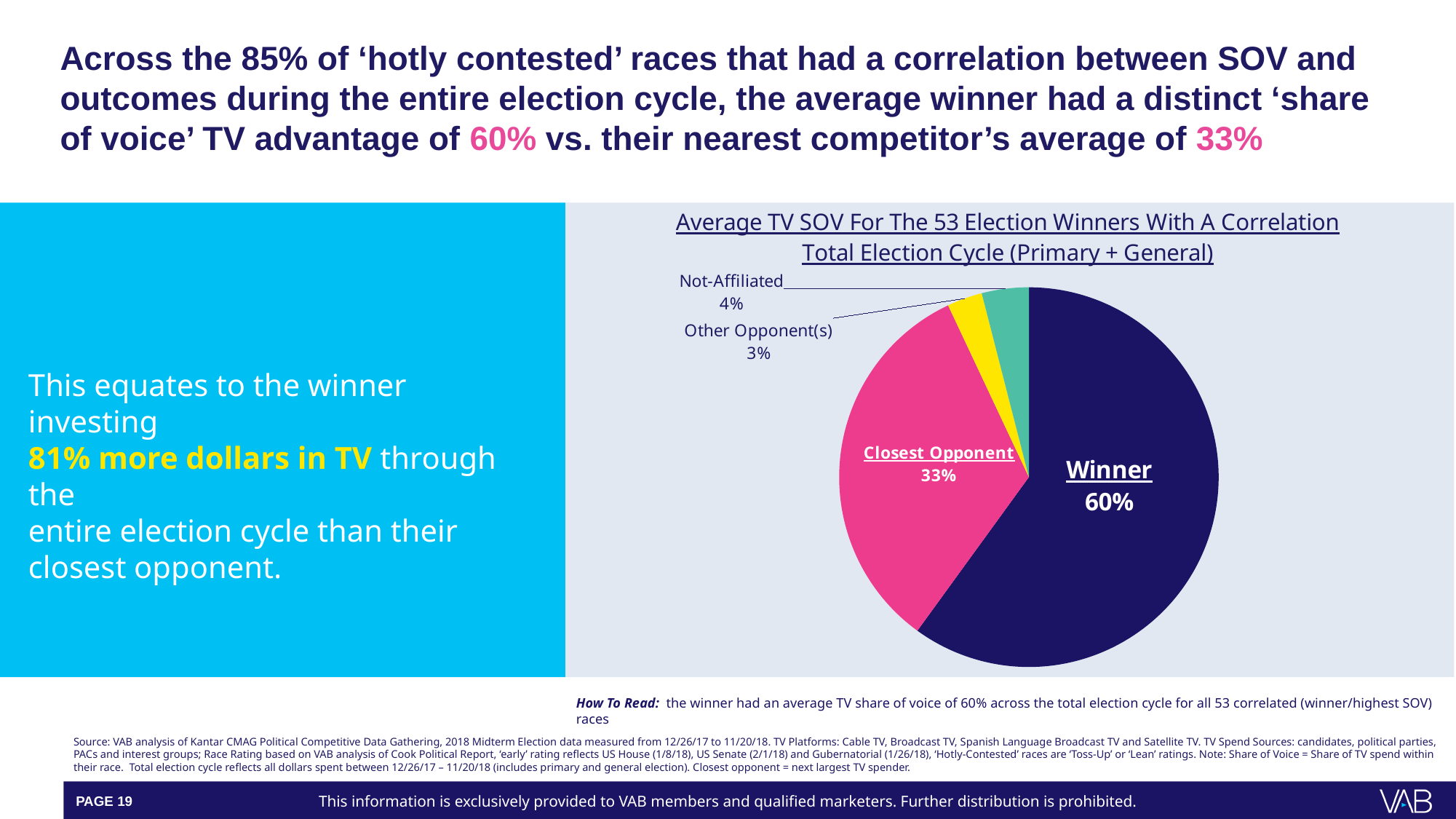
What is the share for Not-Affiliated? 4% What is the average TV SOV for the Closest Opponent? 33% Which is larger, the Not-Affiliated share or the Other Opponent(s) share? Not-Affiliated Which slice of the pie is the smallest? Other Opponent(s) What kind of chart is shown on the slide? pie chart What is the share for Other Opponent(s)? 3% What is the difference in percentage points between the Winner and the Closest Opponent? 27 Which slice of the pie is the largest? Winner What is the average TV SOV for the Winner? 60% How many slices does the pie chart have? 4 What is the title of the pie chart? Average TV SOV For The 53 Election Winners With A Correlation Total Election Cycle (Primary + General) What colour is the Closest Opponent slice? pink